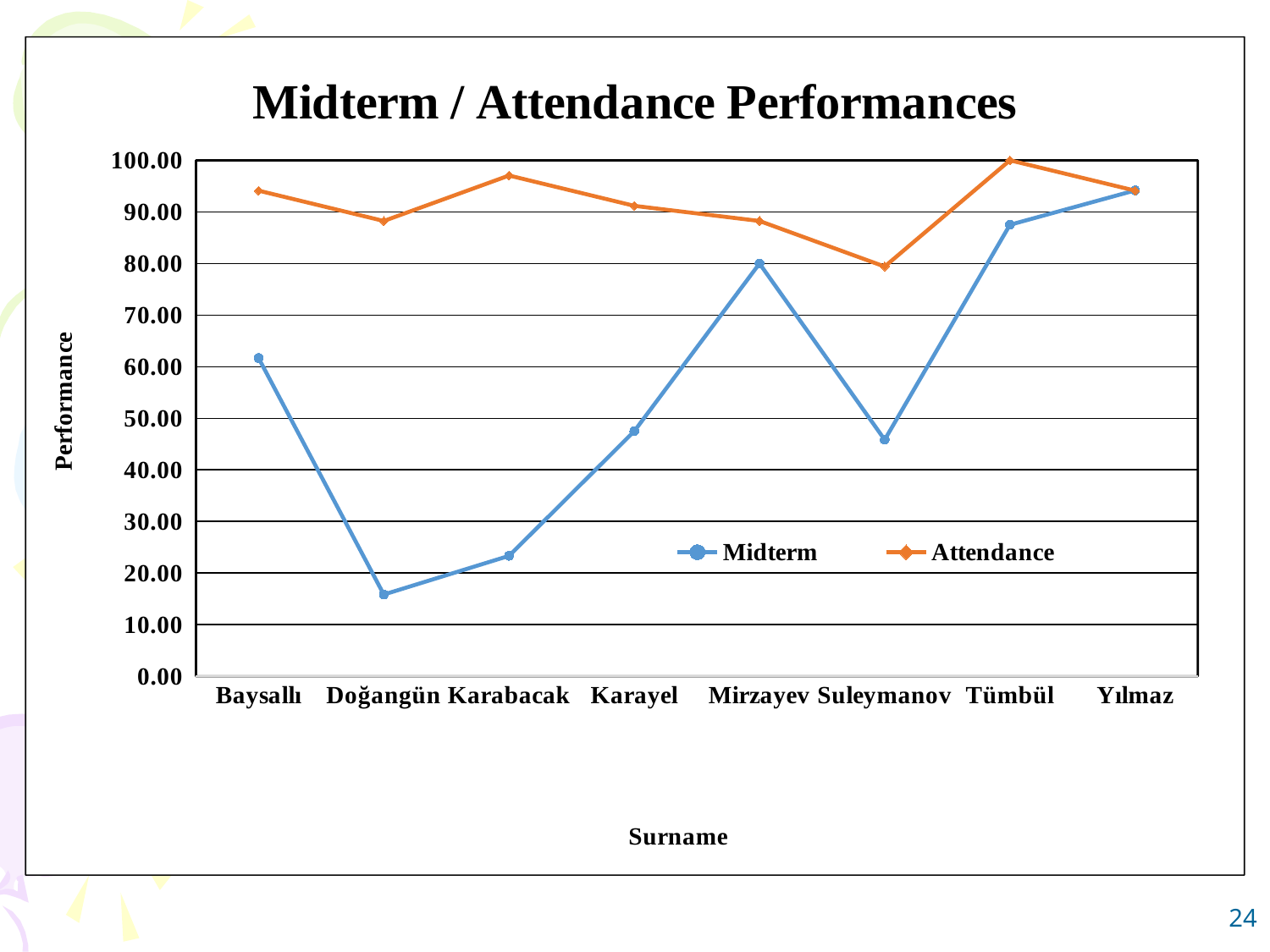
Which surname has the highest Midterm value? Yılmaz How many surnames are plotted along the x axis? 8 Which is larger for Mirzayev: the Midterm value or the Attendance value? Attendance Which surname has the highest Attendance value? Tümbül Which surname has the lowest Attendance value? Suleymanov Is the Midterm value for Baysallı greater or less than 50.00? greater How many series does the legend list? 2 What is the title of the x axis? Surname Is the Attendance value for Karabacak greater or less than 90.00? greater What kind of chart is shown on the slide? line chart Which surname has the lowest Midterm value? Doğangün Is the Midterm value for Doğangün greater or less than 20.00? less